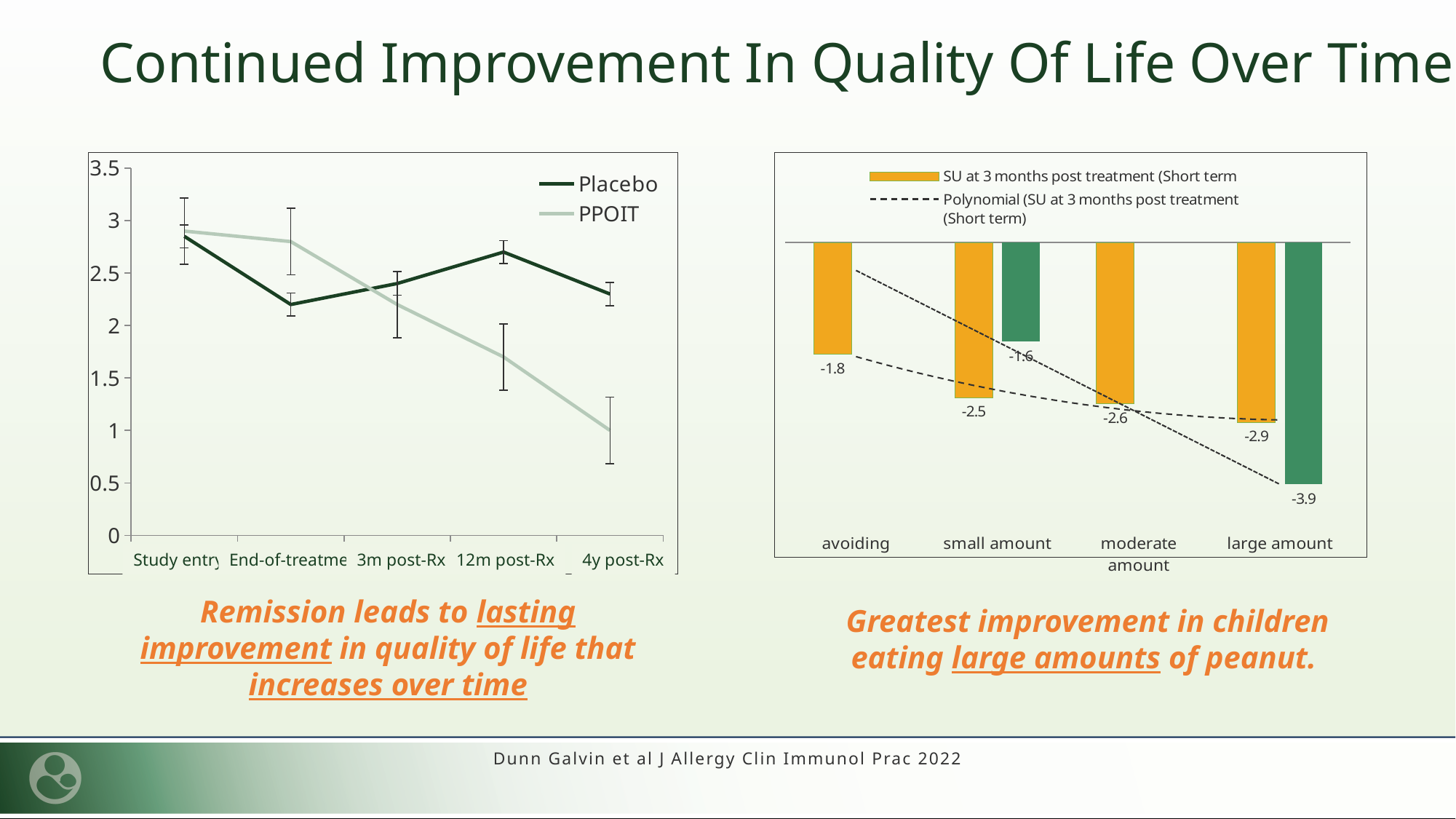
What kind of chart is the right chart? bar chart On the right chart, what is the value of the orange bar for moderate amount? -2.6 On the right chart, what is the value of the orange 'SU at 3 months post treatment (Short term)' bar for avoiding? -1.8 On the left chart, how many series does the legend list? 2 On the left chart, is the PPOIT value at 4y post-Rx greater or less than 1.5? less On the right chart, what is the difference between the orange bar values for avoiding (-1.8) and large amount (-2.9)? 1.1 On the right chart, which category has the lowest (most negative) orange bar value? large amount On the left chart, how many time points are shown on the x axis? 5 On the left chart, which series has the higher value at 4y post-Rx, Placebo or PPOIT? Placebo On the left chart, what are the two series named in the legend? Placebo and PPOIT On the left chart, does the PPOIT line rise or fall from Study entry to 4y post-Rx? fall On the left chart, is the Placebo value at 12m post-Rx greater or less than 2.5? greater